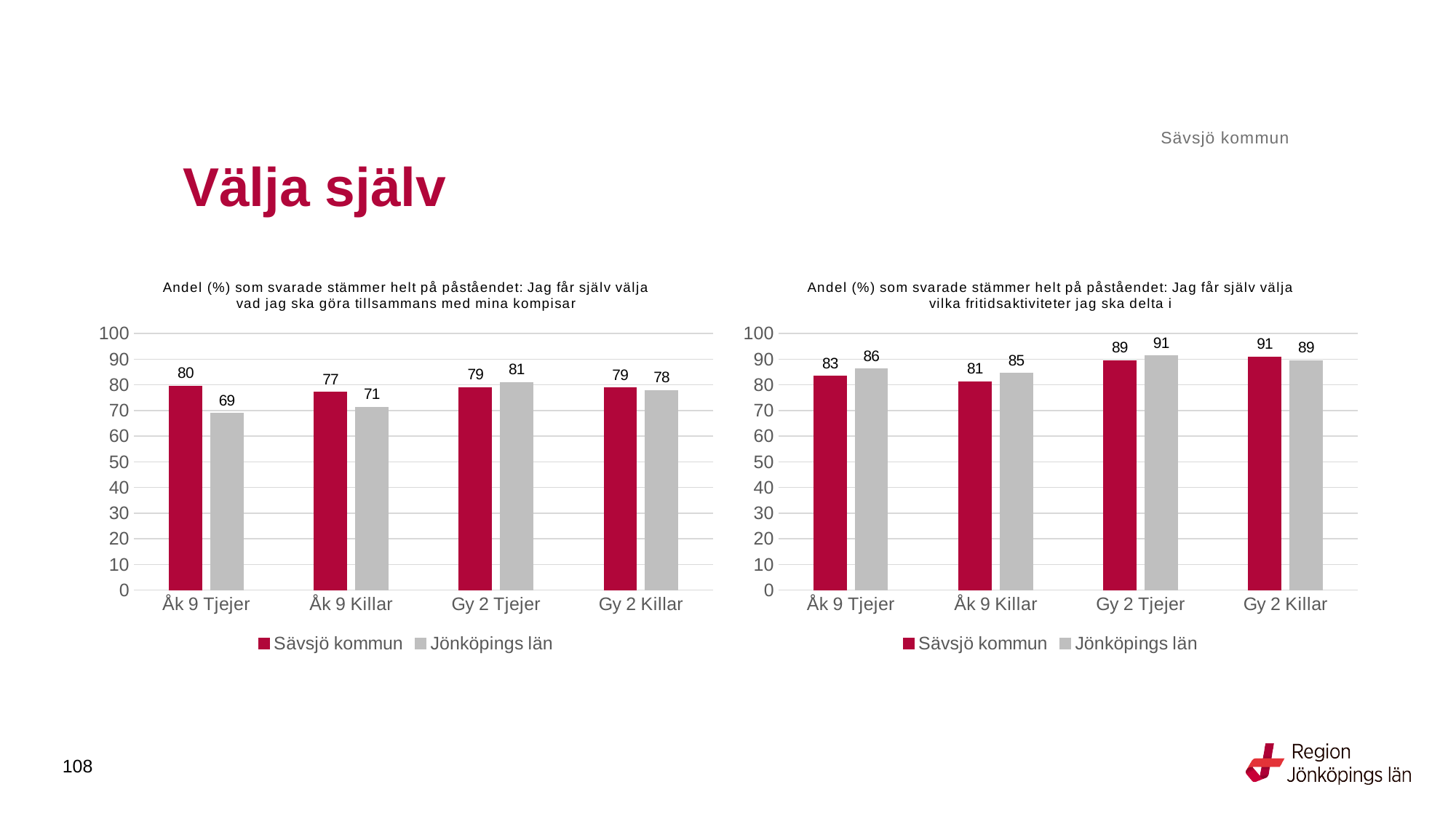
In the right chart (about choosing leisure activities), which is larger for Åk 9 Tjejer: Sävsjö kommun or Jönköpings län? Jönköpings län In the left chart (about choosing what to do with friends), which category has the lowest value for Jönköpings län? Åk 9 Tjejer How many categories are shown on the x axis of the left chart? 4 In the right chart (about choosing leisure activities), what is the value for Jönköpings län for Gy 2 Tjejer? 91 What kind of chart is the left chart? Bar chart In the left chart (about choosing what to do with friends), what is the value for Jönköpings län for Åk 9 Killar? 71 In the right chart (about choosing leisure activities), which category has the highest value for Sävsjö kommun? Gy 2 Killar In the left chart (about choosing what to do with friends), what is the value for Sävsjö kommun for Åk 9 Tjejer? 80 How many series does the legend of the right chart list? 2 In the left chart (about choosing what to do with friends), what is the difference between Sävsjö kommun and Jönköpings län for Åk 9 Tjejer? 11 In the right chart (about choosing leisure activities), what is the difference between Jönköpings län and Sävsjö kommun for Åk 9 Killar? 4 In the right chart (about choosing leisure activities), what is the value for Sävsjö kommun for Åk 9 Killar? 81